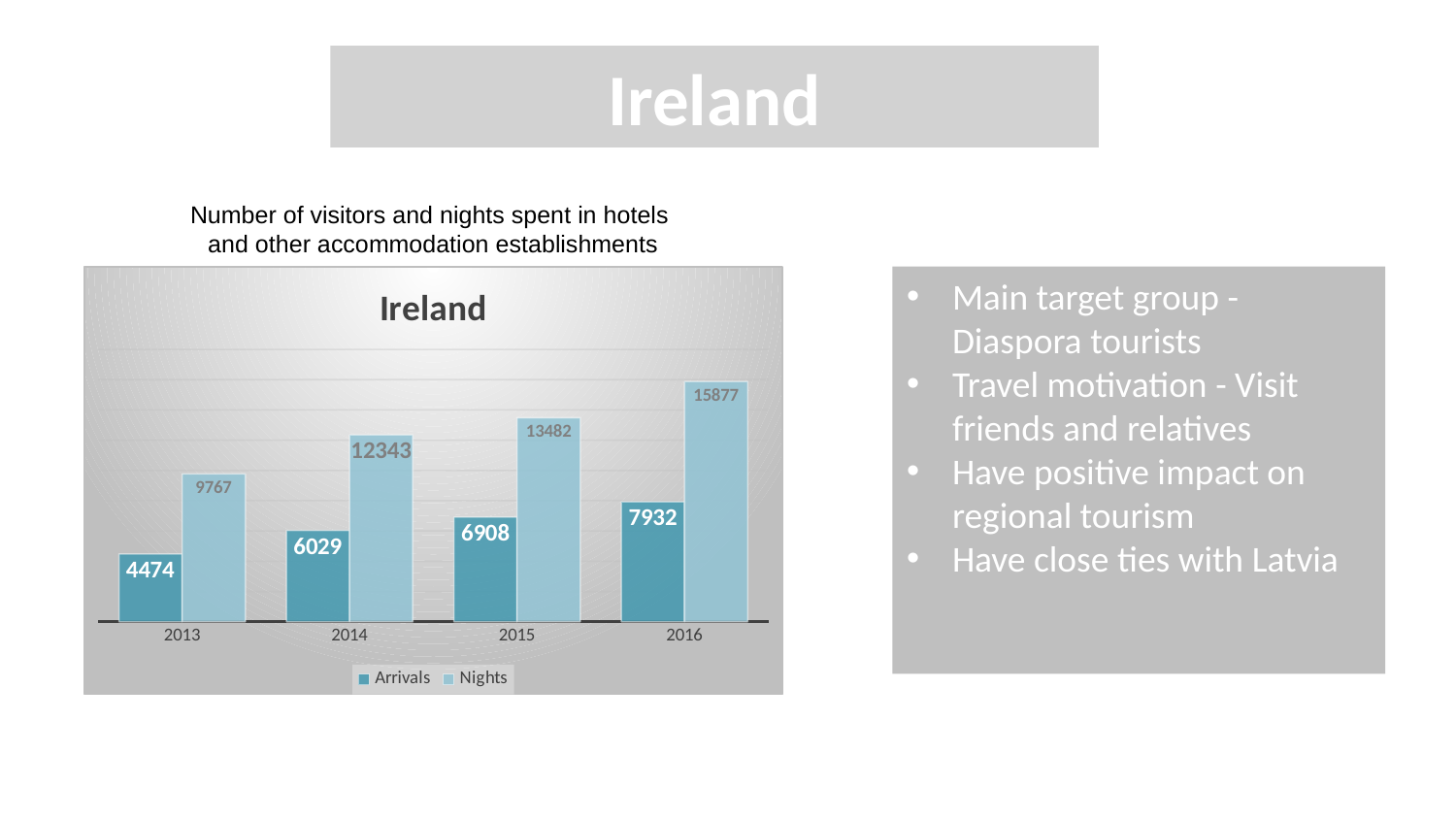
What is the difference between Nights and Arrivals in 2015? 6574 How many series does the legend list? 2 Which is larger, Arrivals in 2016 or Nights in 2013? Nights in 2013 What is the value of Arrivals for 2013? 4474 Which year has the lowest value for Arrivals? 2013 What is the difference in Arrivals between 2016 and 2013? 3458 What is the value of Nights for 2014? 12343 Which year has the highest value for Nights? 2016 What is the value of Nights for 2016? 15877 How many years are shown on the x axis? 4 What kind of chart is shown? Bar chart What is the value of Arrivals for 2015? 6908